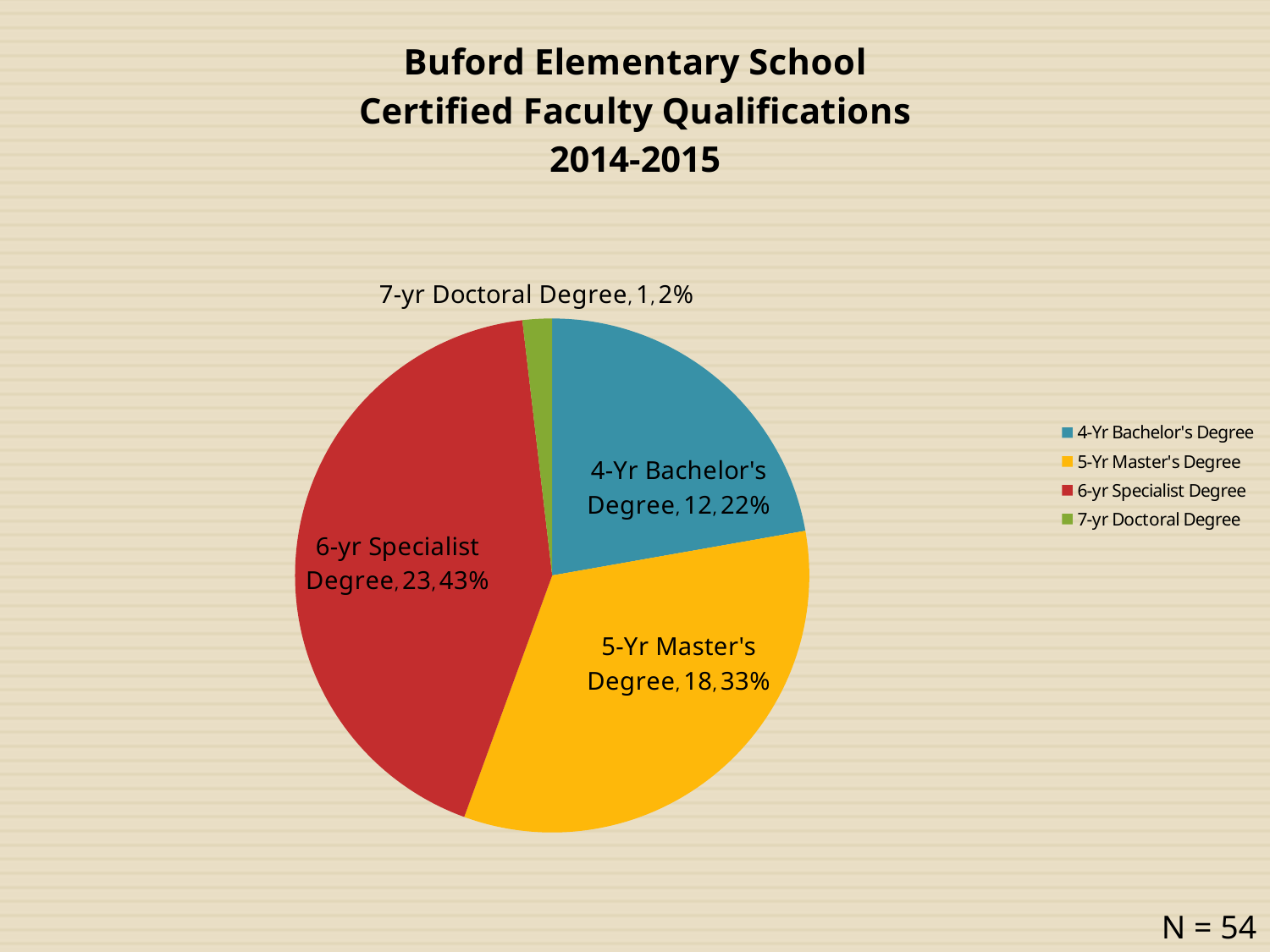
Which is larger: the number of faculty with a 5-Yr Master's Degree or with a 4-Yr Bachelor's Degree? 5-Yr Master's Degree How many faculty members hold a 5-Yr Master's Degree? 18 What colour is the slice for the 5-Yr Master's Degree? yellow What kind of chart is shown on the slide? pie chart What percentage of certified faculty hold a 7-yr Doctoral Degree? 2% How many faculty members hold a 4-Yr Bachelor's Degree? 12 What percentage of certified faculty hold a 6-yr Specialist Degree? 43% Which degree category has the smallest share of the pie? 7-yr Doctoral Degree How many more faculty members hold a 6-yr Specialist Degree than a 4-Yr Bachelor's Degree? 11 What is the total number of certified faculty shown on the slide? 54 How many degree categories are shown in the pie chart? 4 Which degree category has the largest share of the pie? 6-yr Specialist Degree